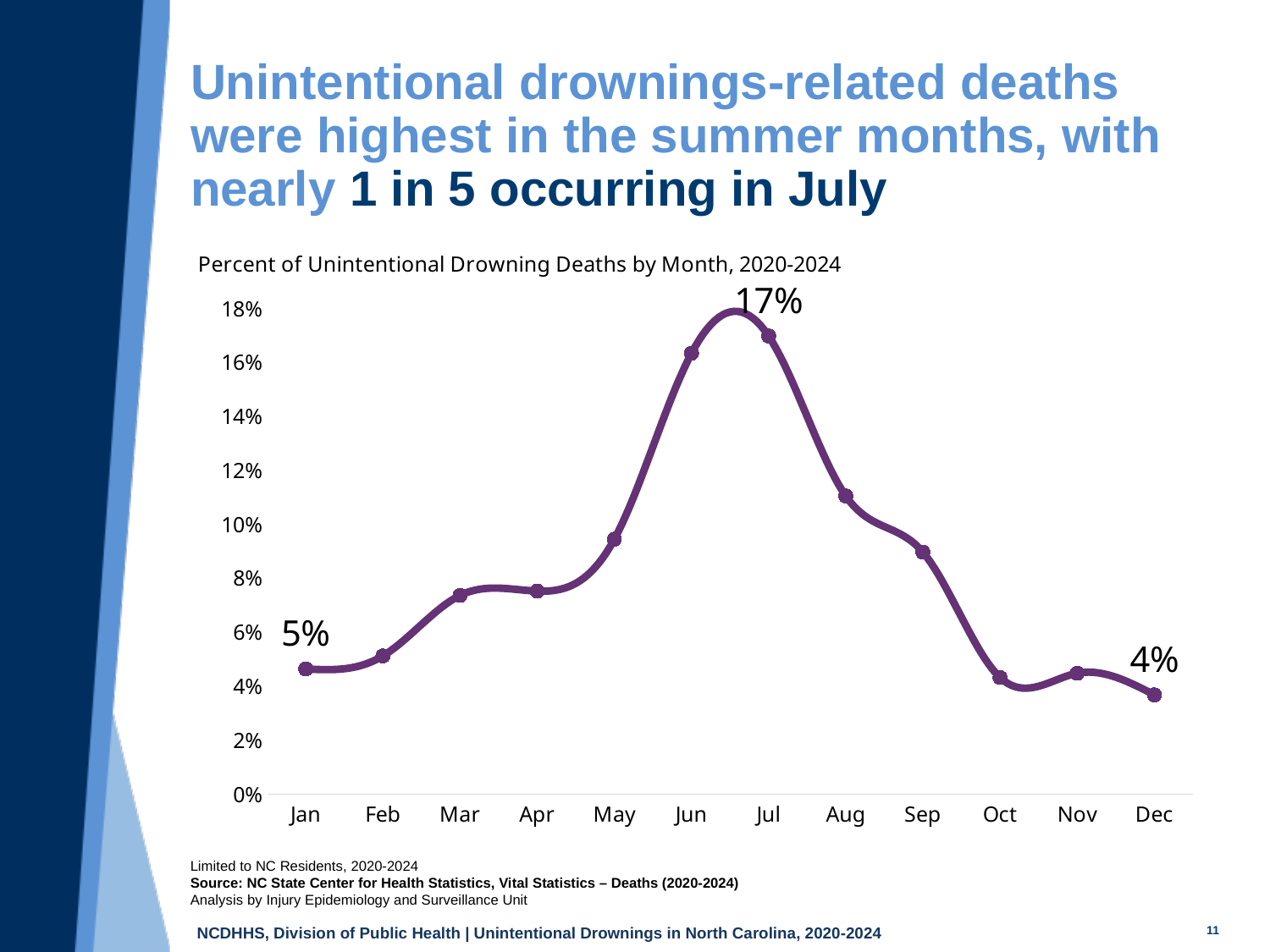
What percent of unintentional drowning deaths occurred in December? 4% Is the value for May greater or less than 8%? greater What is the difference in percentage points between July and January? 12 percentage points What is the difference in percentage points between January and December? 1 percentage point Which month has a higher value, June or August? Jun Which month has the highest percent of unintentional drowning deaths? Jul What percent of unintentional drowning deaths occurred in January? 5% Is the value for June greater or less than 14%? greater What type of chart is shown on the slide? Line chart How many months are plotted on the x axis? 12 Is the value for August greater or less than 12%? less What percent of unintentional drowning deaths occurred in July? 17%